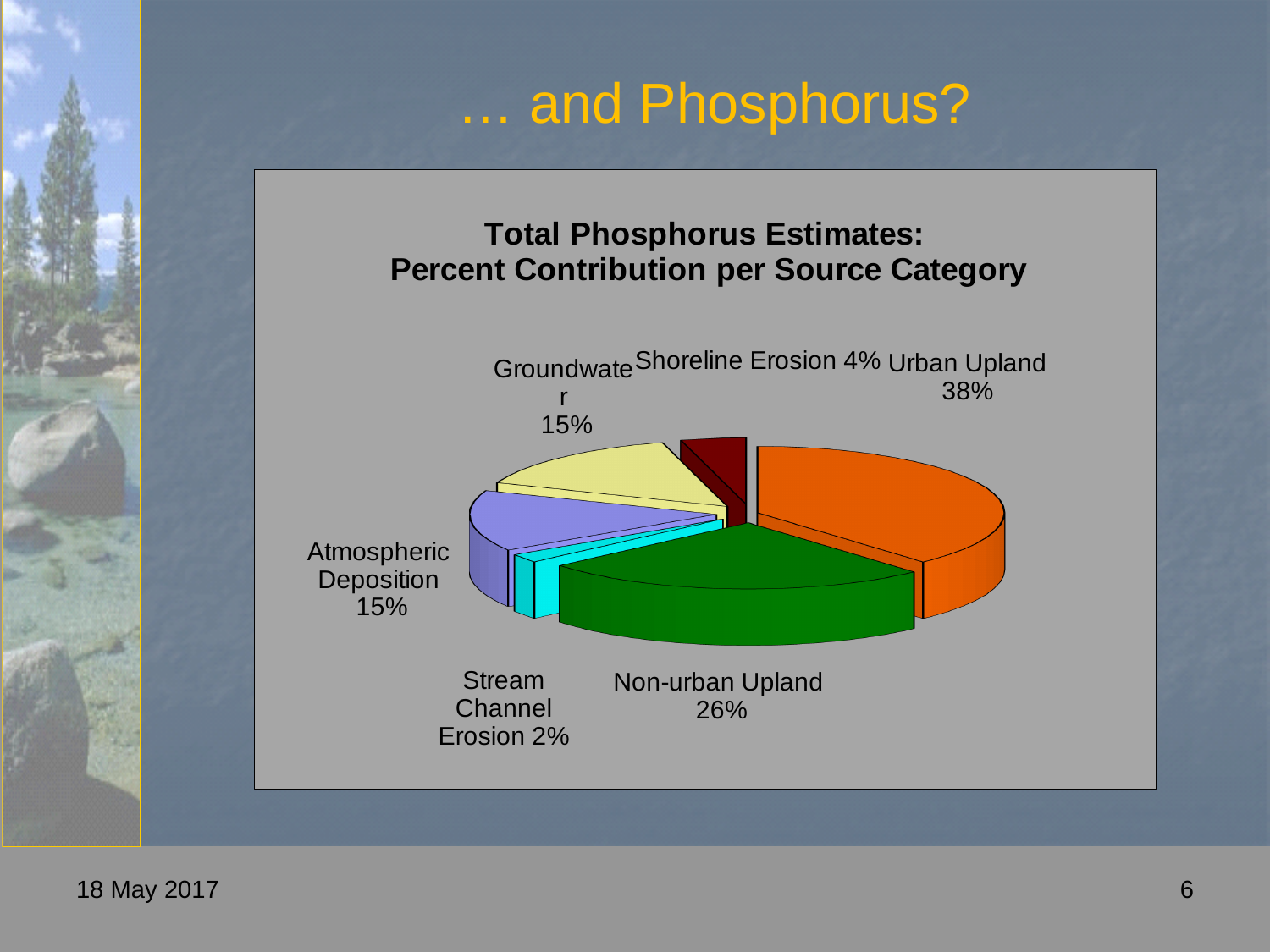
What percentage of total phosphorus is attributed to Urban Upland? 38% Which contributes more to total phosphorus, Groundwater or Shoreline Erosion? Groundwater What percentage of total phosphorus is attributed to Non-urban Upland? 26% What type of chart is shown on the slide? pie chart How many source categories are shown in the pie chart? 6 Which source category contributes the smallest share of total phosphorus? Stream Channel Erosion What is the difference in percentage points between Urban Upland and Non-urban Upland? 12 Which source category contributes the largest share of total phosphorus? Urban Upland What is the title of the chart? Total Phosphorus Estimates: Percent Contribution per Source Category What colour is the Non-urban Upland slice? green What percentage of total phosphorus is attributed to Stream Channel Erosion? 2% What percentage of total phosphorus is attributed to Shoreline Erosion? 4%